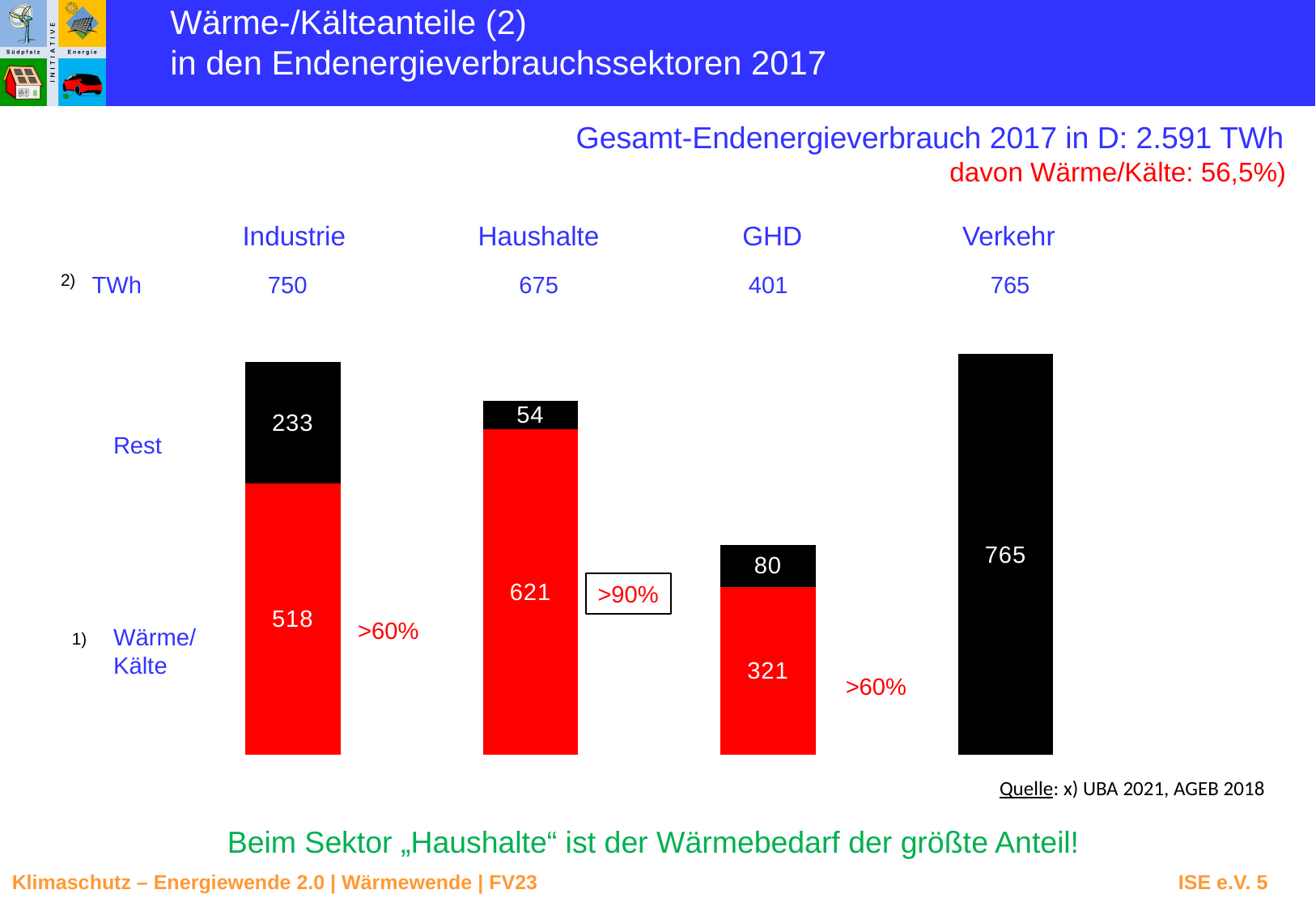
What is the difference between the Wärme/Kälte value for Haushalte and the Wärme/Kälte value for GHD? 300 What is the Rest value for Haushalte? 54 What is the Wärme/Kälte value for GHD? 321 What kind of chart is shown on the slide? Stacked bar chart What is the total of the stacked bar for Industrie? 750 Which sector has the lowest total TWh value? GHD Which sector has the highest Wärme/Kälte value? Haushalte What percentage label is shown next to the Haushalte bar? >90% Which is larger, the Rest value for Industrie or the Rest value for GHD? Industrie What is the Wärme/Kälte value for Industrie? 518 How many sectors are shown in the chart? 4 What is the total TWh value shown for Verkehr? 765